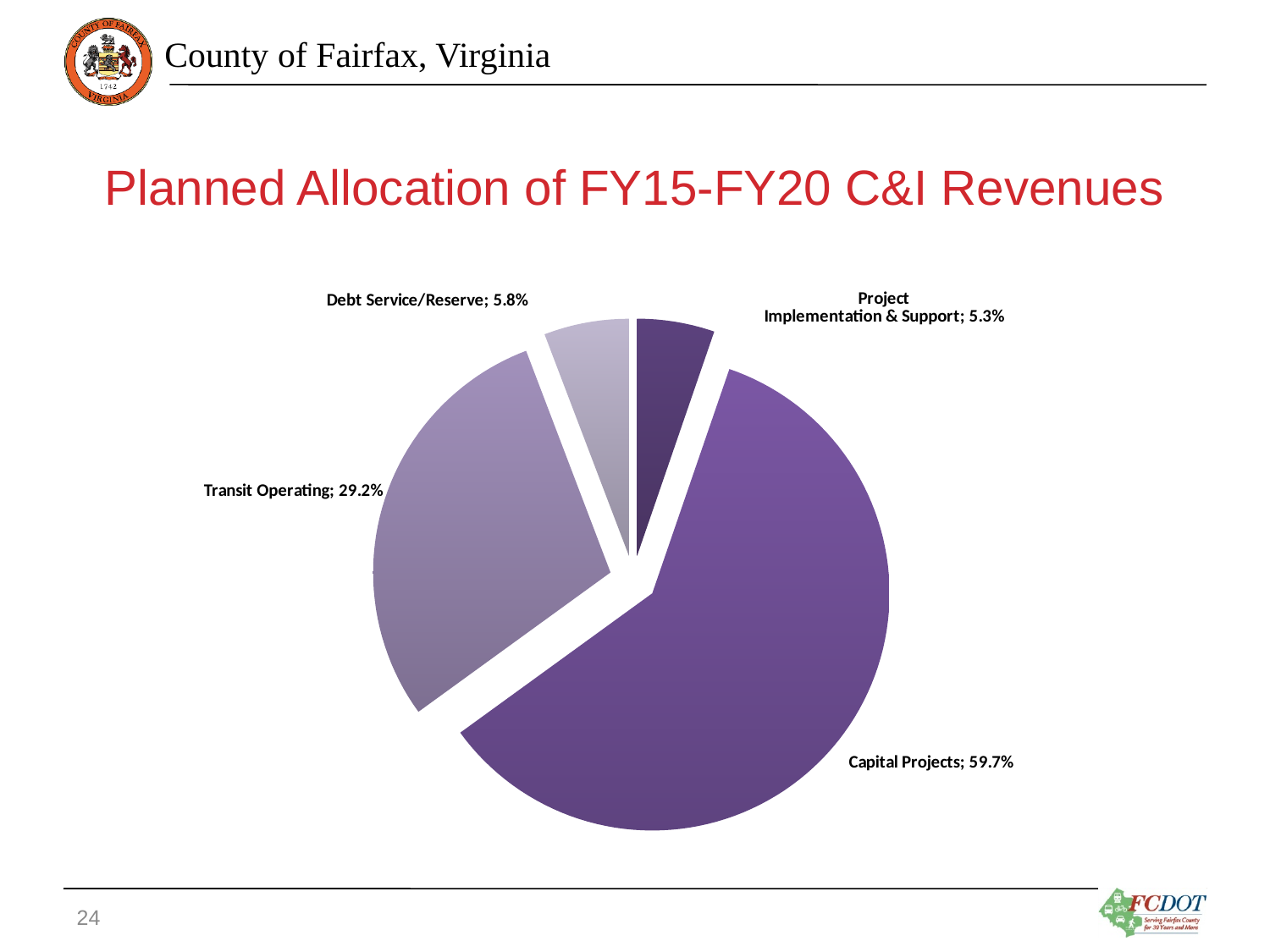
What is the value shown for Project Implementation & Support? 5.3% Which is larger, Transit Operating or Debt Service/Reserve? Transit Operating How many categories are shown in the pie chart? 4 What share of the pie does Transit Operating represent? 29.2% What is the value shown for Debt Service/Reserve? 5.8% What share of the pie does Capital Projects represent? 59.7% What is the difference in percentage points between Debt Service/Reserve and Project Implementation & Support? 0.5 Which category has the smallest slice of the pie? Project Implementation & Support What is the title of the slide containing the chart? Planned Allocation of FY15-FY20 C&I Revenues Which category has the largest slice of the pie? Capital Projects What kind of chart is shown on the slide? Pie chart What is the difference in percentage points between Capital Projects and Transit Operating? 30.5